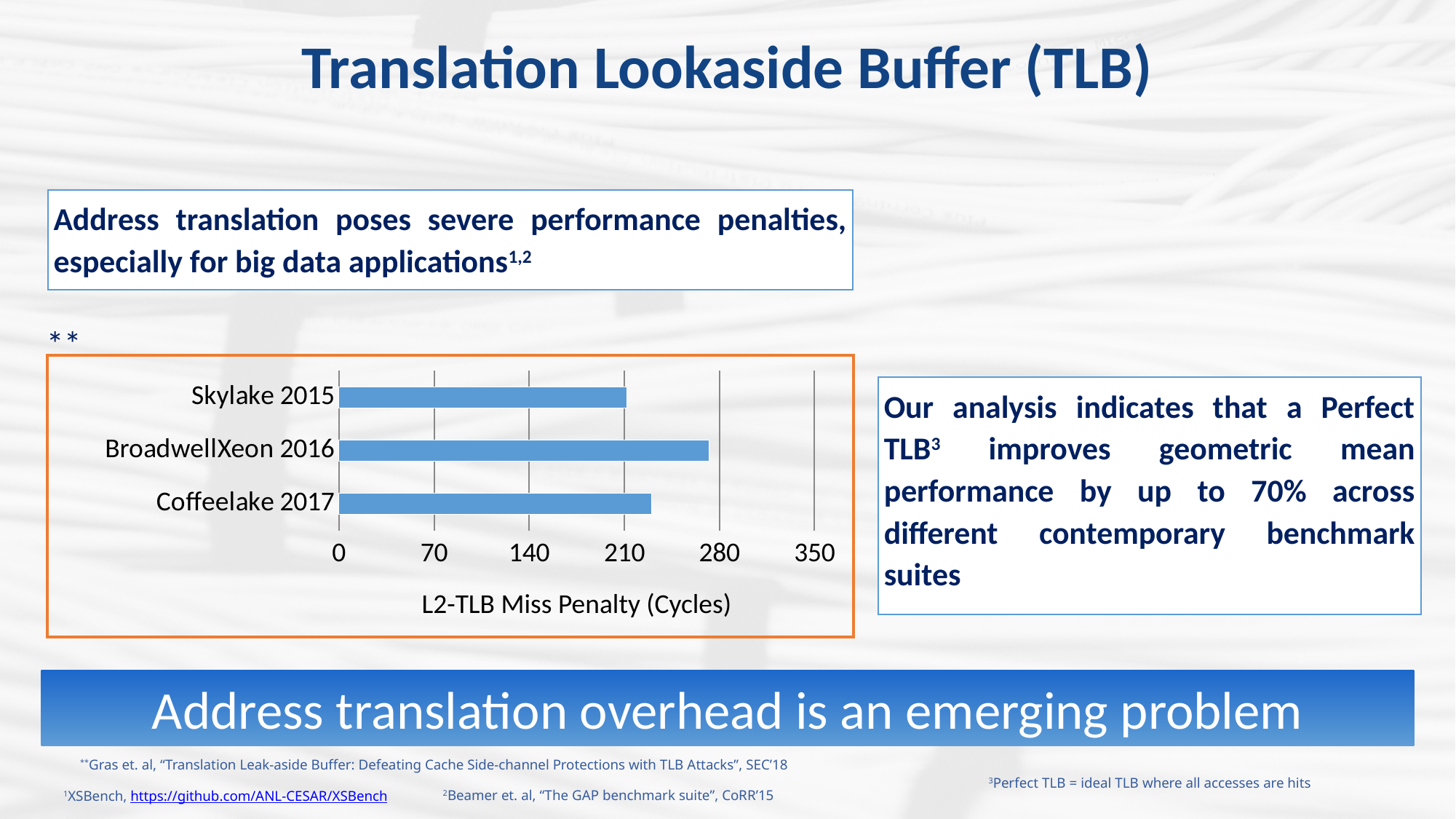
What is the highest value labelled on the chart's horizontal axis? 350 Is the L2-TLB miss penalty for Skylake 2015 greater or less than 140 cycles? greater What is the title of the horizontal axis of the chart? L2-TLB Miss Penalty (Cycles) Which processor has the highest L2-TLB miss penalty in the chart? BroadwellXeon 2016 Is the L2-TLB miss penalty for Coffeelake 2017 greater or less than 280 cycles? less What kind of chart is shown on the slide? bar chart Is the L2-TLB miss penalty for BroadwellXeon 2016 greater or less than 210 cycles? greater How many processors (categories) are plotted in the chart? 3 Which has a larger L2-TLB miss penalty, Skylake 2015 or Coffeelake 2017? Coffeelake 2017 Which processor has the lowest L2-TLB miss penalty in the chart? Skylake 2015 Which has a larger L2-TLB miss penalty, BroadwellXeon 2016 or Coffeelake 2017? BroadwellXeon 2016